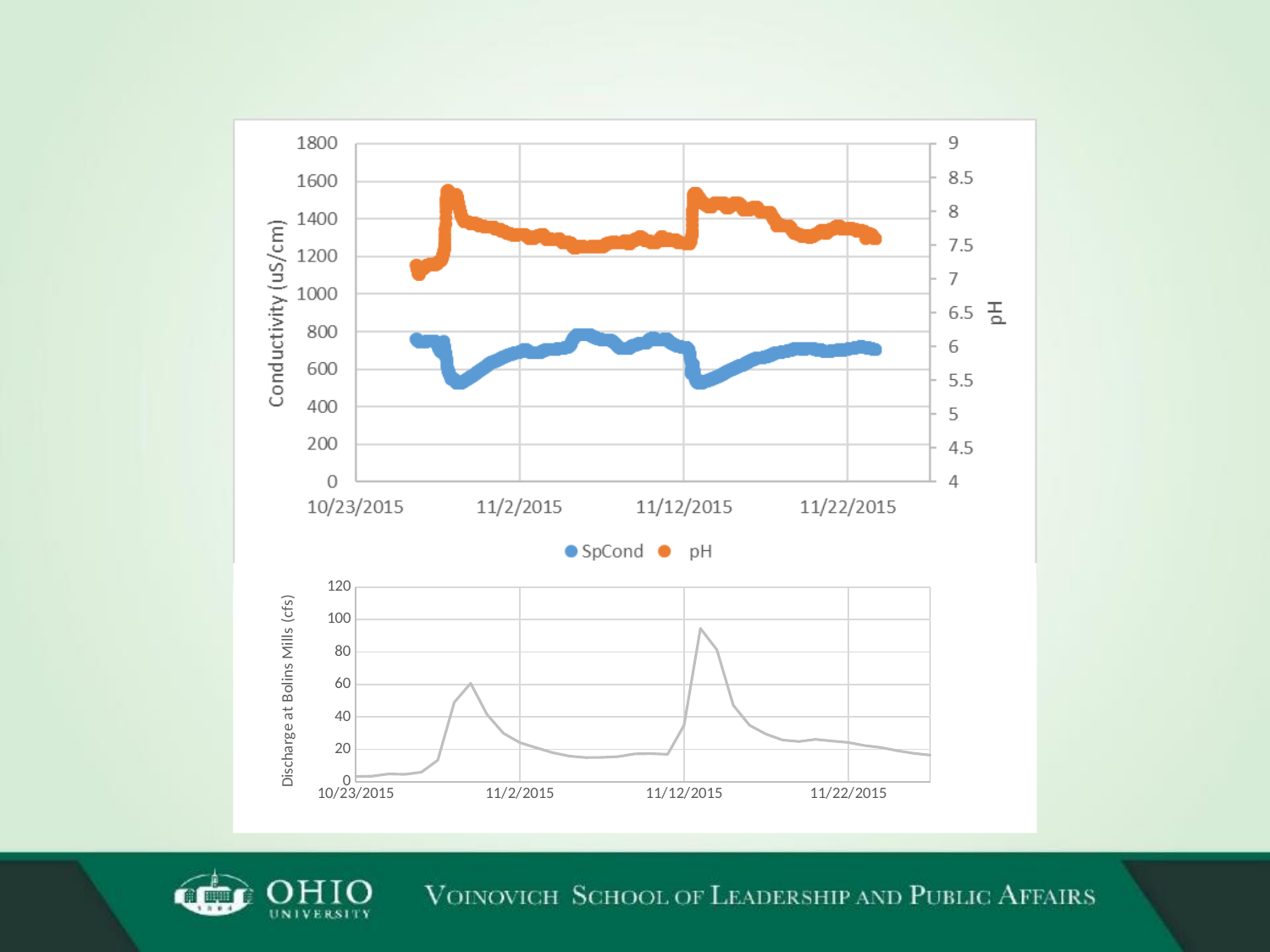
In the bottom chart, is the discharge peak near 11/12/2015 greater or less than 80 cfs? greater How many series does the legend of the top chart list? 2 In the bottom chart, is the discharge peak between 10/23/2015 and 11/2/2015 greater or less than 80 cfs? less In the top chart, is the pH series greater or less than 6.5 throughout the period shown? greater What is the maximum value shown on the right-hand pH axis of the top chart? 9 In the bottom chart, which discharge peak is higher: the one before 11/2/2015 or the one near 11/12/2015? the one near 11/12/2015 What is the label of the left vertical axis of the top chart? Conductivity (uS/cm) What kind of chart is the bottom chart showing discharge at Bolins Mills? line chart What are the two series named in the legend of the top chart? SpCond and pH